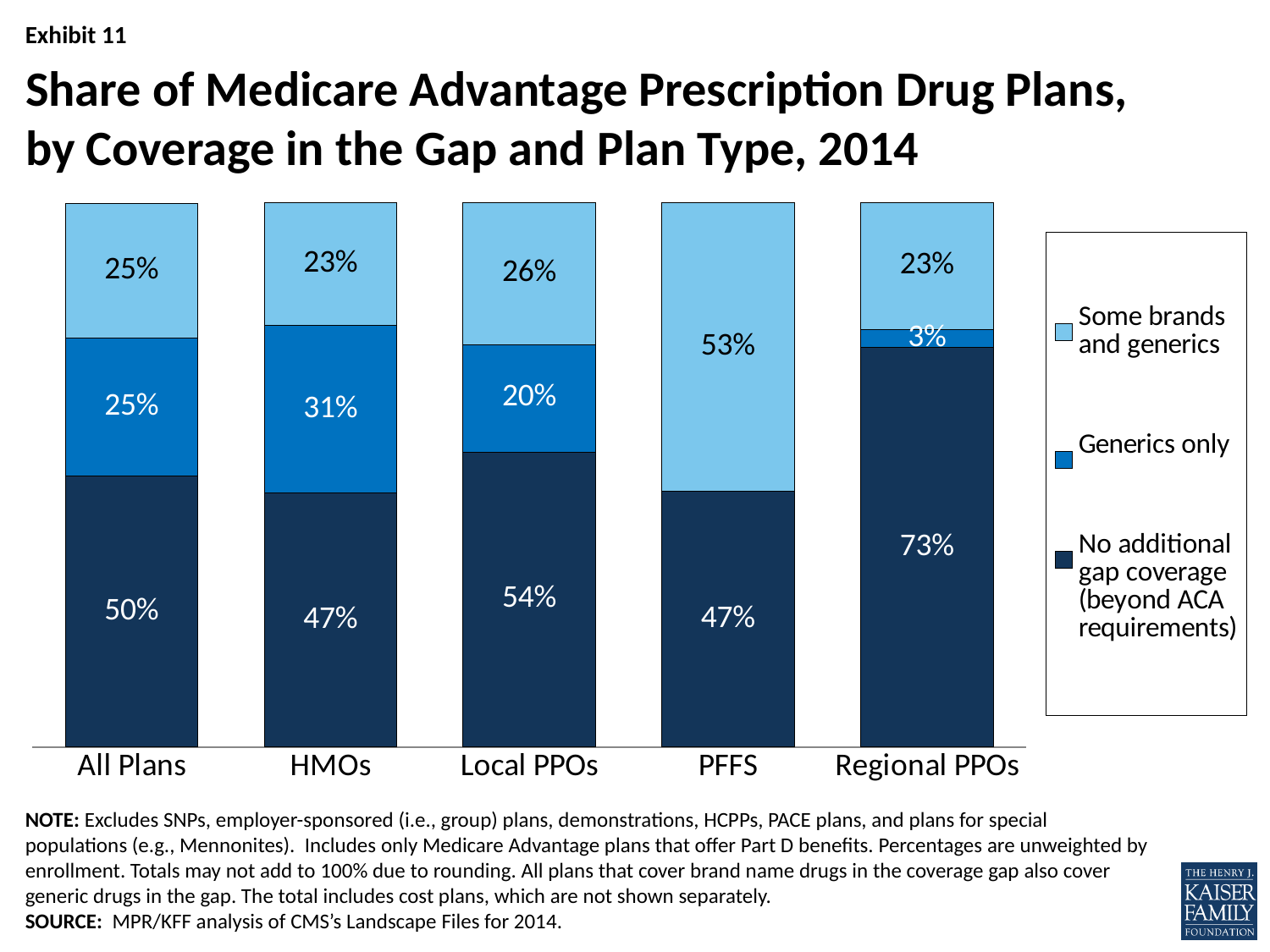
What share of PFFS plans cover some brands and generics in the gap? 53% Which legend entry is shown in the darkest blue? No additional gap coverage (beyond ACA requirements) How many plan types are shown on the x axis? 5 What share of Local PPOs have generics-only gap coverage? 20% Which is larger: the share of HMOs or the share of All Plans with generics-only gap coverage? HMOs What share of HMOs have generics-only gap coverage? 31% What share of Regional PPOs have no additional gap coverage (beyond ACA requirements)? 73% How many series does the legend list? 3 Which plan type has the highest share with no additional gap coverage? Regional PPOs What is the difference between the share of Local PPOs and the share of HMOs with no additional gap coverage? 7 percentage points What kind of chart is shown on the slide? Stacked bar chart Which plan type has the lowest share with generics-only gap coverage? PFFS